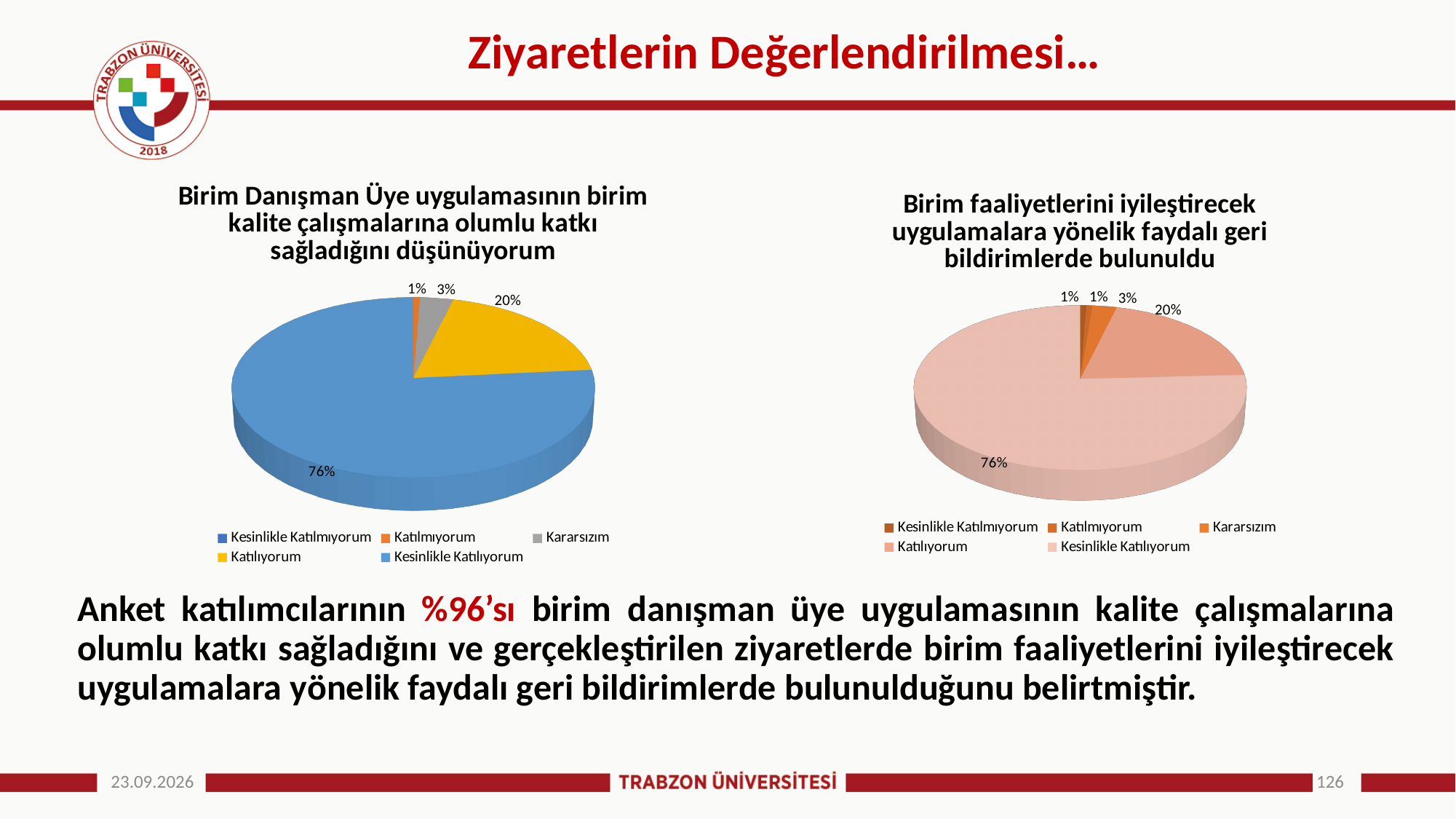
In the left chart, what share does the Katılıyorum slice have? 20% In the right chart (Birim faaliyetlerini iyileştirecek uygulamalara yönelik faydalı geri bildirimlerde bulunuldu), what is the value of the largest slice? 76% In the left chart, what is the difference between the Kesinlikle Katılıyorum slice and the Katılıyorum slice? 56% In the left chart (Birim Danışman Üye uygulamasının birim kalite çalışmalarına olumlu katkı sağladığını düşünüyorum), what is the largest slice's value? 76% How many entries does the legend of the left chart list? 5 In the right chart, what share does the Kararsızım slice have? 3% In the right chart, how many slices have data labels? 5 In the left chart, which legend category corresponds to the largest slice? Kesinlikle Katılıyorum In the right chart, what share does the Katılıyorum slice have? 20% In the left chart, what share does the Kararsızım slice have? 3% What kind of charts are shown on the slide? Pie charts In the right chart, which is larger: the Katılıyorum slice or the Kararsızım slice? Katılıyorum